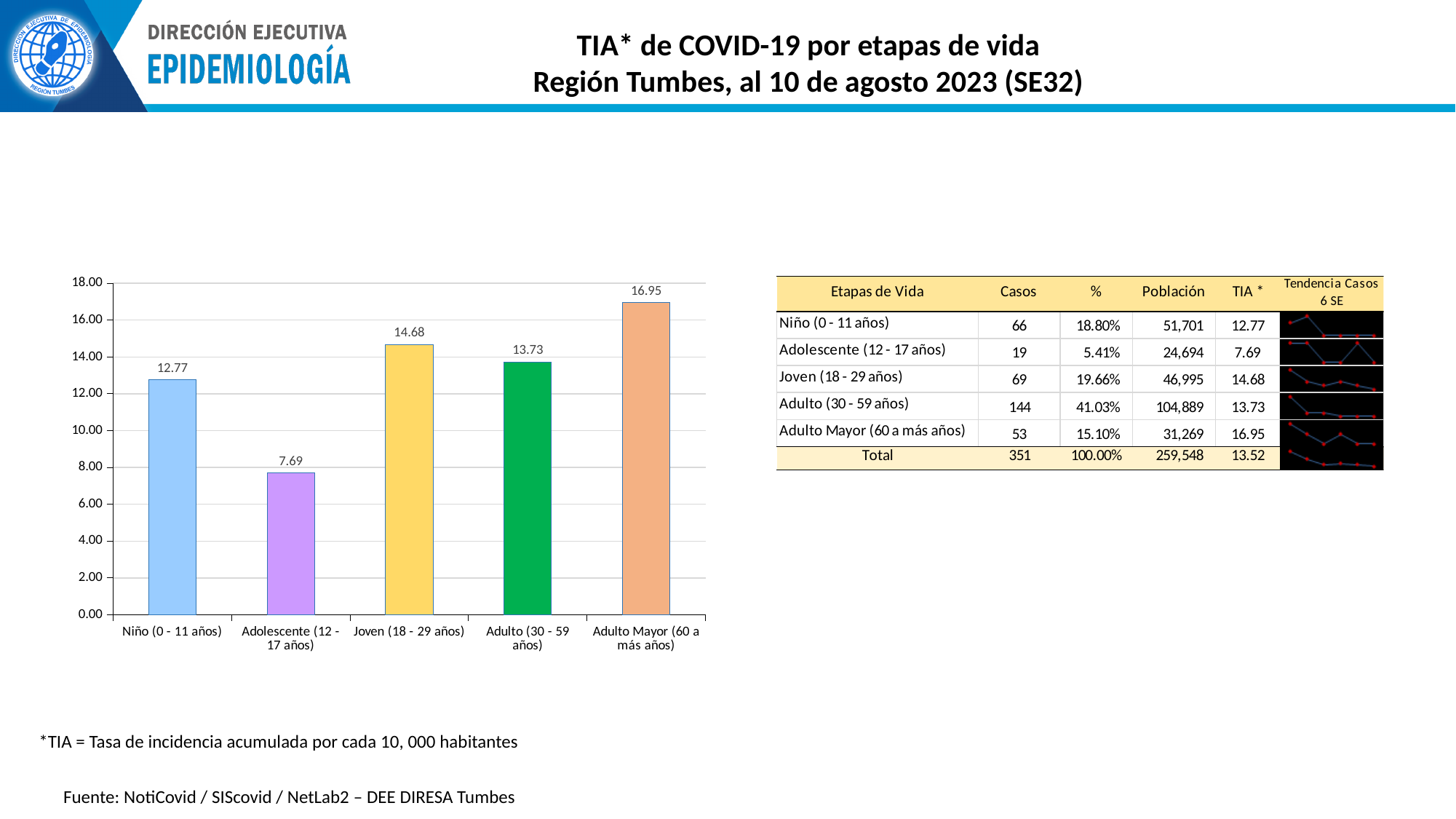
What is the TIA value for Adolescente (12 - 17 años) in the bar chart? 7.69 What type of chart is used to show TIA by life stage? Bar chart What is the TIA value for Adulto Mayor (60 a más años) in the bar chart? 16.95 What is the maximum value shown on the y axis of the bar chart? 18.00 Is the TIA value for Niño (0 - 11 años) greater or less than 12.00? greater Which life stage has the highest TIA in the bar chart? Adulto Mayor (60 a más años) Which has a higher TIA in the bar chart, Joven (18 - 29 años) or Adulto (30 - 59 años)? Joven (18 - 29 años) What is the TIA value for Joven (18 - 29 años) in the bar chart? 14.68 What is the difference between the TIA for Adulto Mayor (60 a más años) and Adolescente (12 - 17 años)? 9.26 How many life-stage categories are shown in the bar chart? 5 What is the TIA value for Niño (0 - 11 años) in the bar chart? 12.77 Which life stage has the lowest TIA in the bar chart? Adolescente (12 - 17 años)